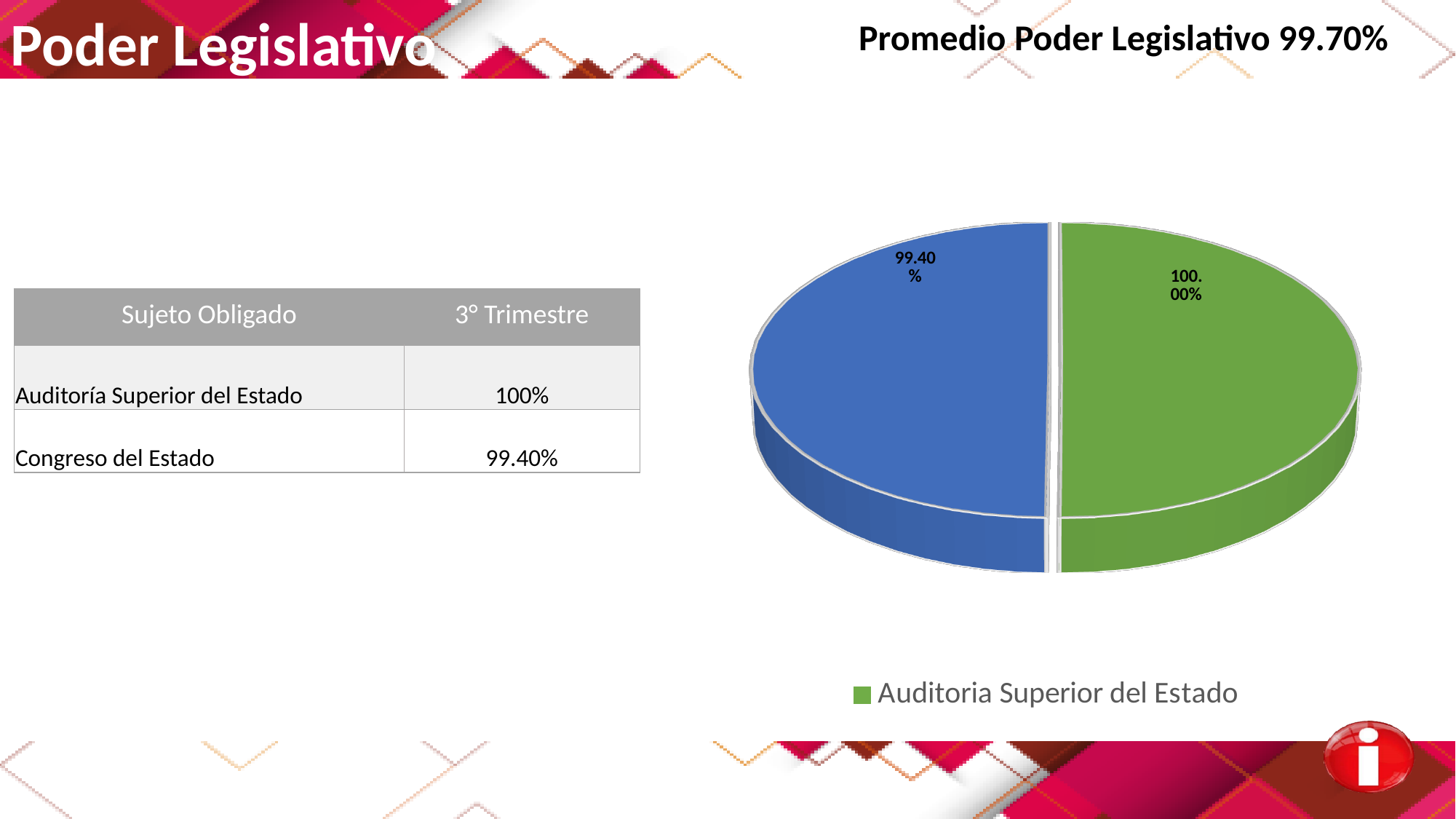
What colour is the slice for Auditoria Superior del Estado in the pie chart? green What is the name of the entry shown in the pie chart's legend? Auditoria Superior del Estado How many slices does the pie chart have? 2 Which slice of the pie chart carries the lower labelled value, the green one or the blue one? the blue one What value is labelled on the green slice (Auditoria Superior del Estado) of the pie chart? 100.00% What kind of chart is shown on the slide? pie chart What value is labelled on the blue slice of the pie chart? 99.40% Is the labelled value on the green slice larger or smaller than the labelled value on the blue slice? larger Which slice of the pie chart carries the higher labelled value, the green one or the blue one? the green one How many entries does the pie chart's legend list? 1 What is the difference between the labelled values of the green slice (100.00%) and the blue slice (99.40%)? 0.60%